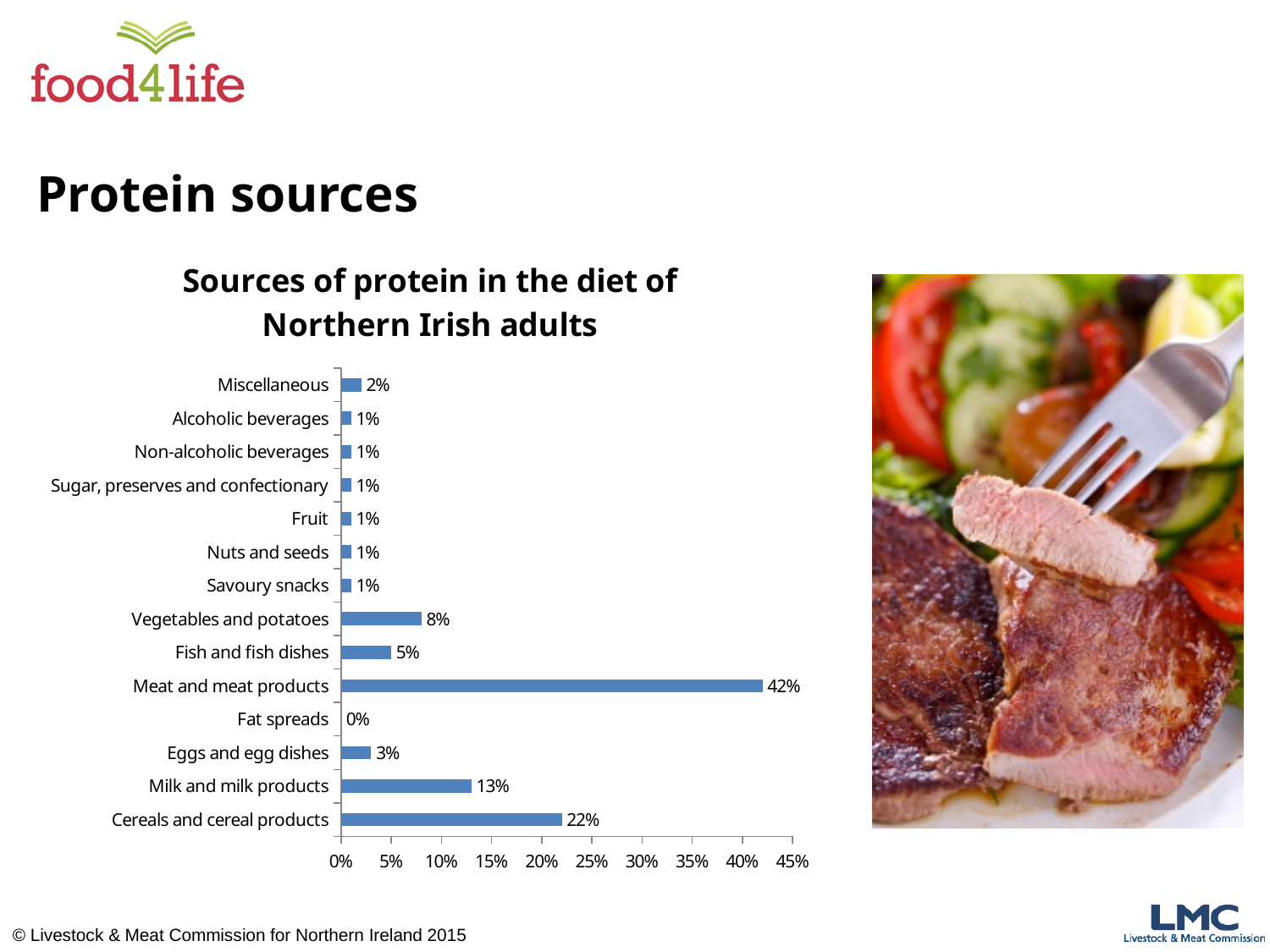
What is the value shown for cereals and cereal products? 22% What is the difference between the values for meat and meat products and cereals and cereal products? 20% What is the value shown for milk and milk products? 13% What is the title of the chart? Sources of protein in the diet of Northern Irish adults What kind of chart is used to show the sources of protein? Bar chart What percentage of protein in the diet of Northern Irish adults comes from meat and meat products? 42% What is the value shown for fat spreads? 0% Which category has the lowest value on the chart? Fat spreads Which category is the largest source of protein? Meat and meat products How many categories are shown on the chart? 14 Is the value for meat and meat products greater or less than 40%? greater Which is larger, the value for vegetables and potatoes or the value for fish and fish dishes? Vegetables and potatoes